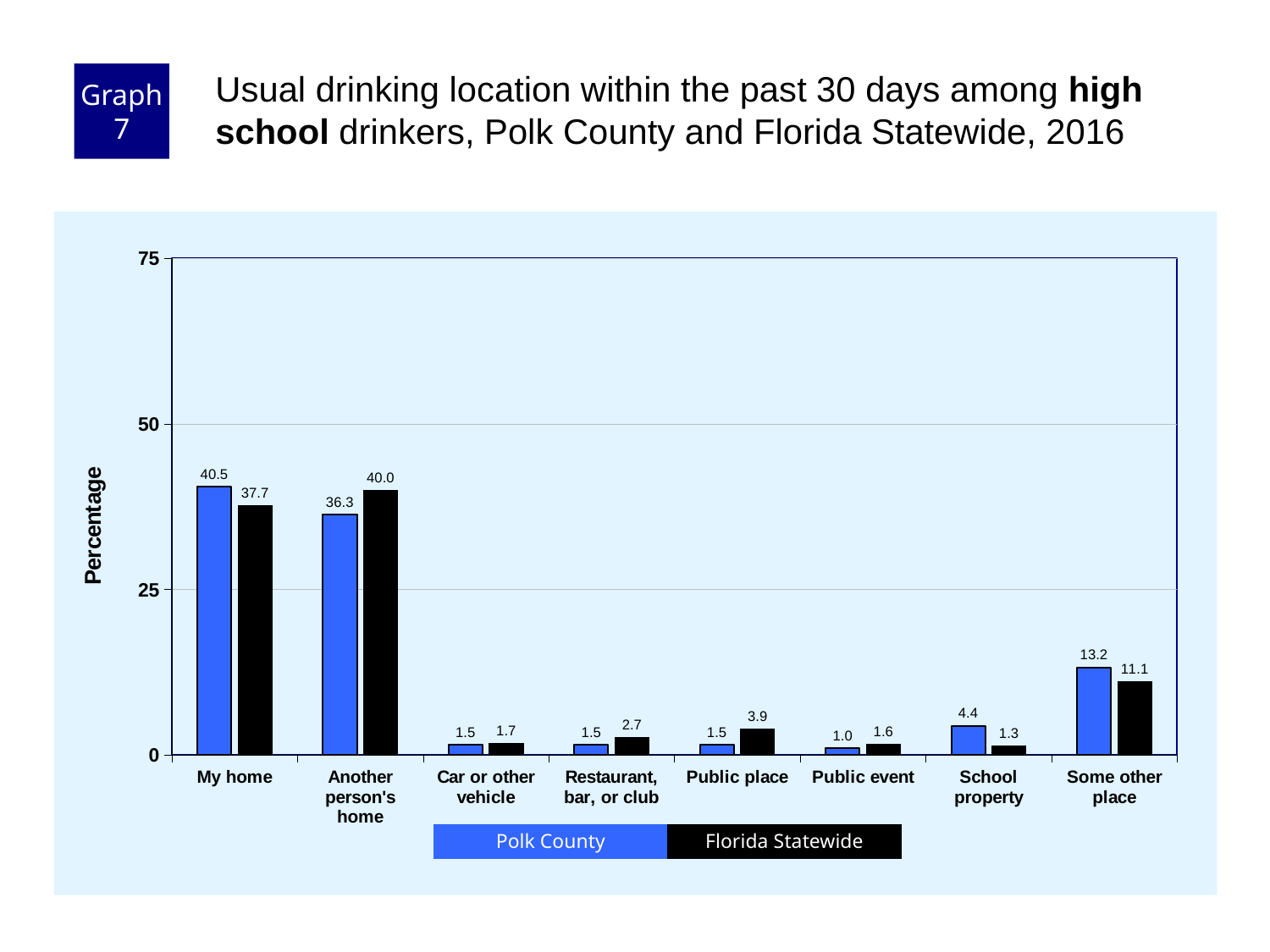
Is the Polk County value for Another person's home greater or less than 25? greater What kind of chart is shown on the slide? Bar chart Which category has the highest Florida Statewide value? Another person's home How many location categories are shown on the x axis? 8 How many series does the legend list? 2 Which is larger for School property: Polk County or Florida Statewide? Polk County What is the Florida Statewide value for Another person's home? 40.0 Which category has the highest Polk County value? My home What is the Florida Statewide value for Public place? 3.9 What is the difference between the Polk County and Florida Statewide values for Some other place? 2.1 What is the Polk County value for My home? 40.5 Which category has the lowest Polk County value? Public event